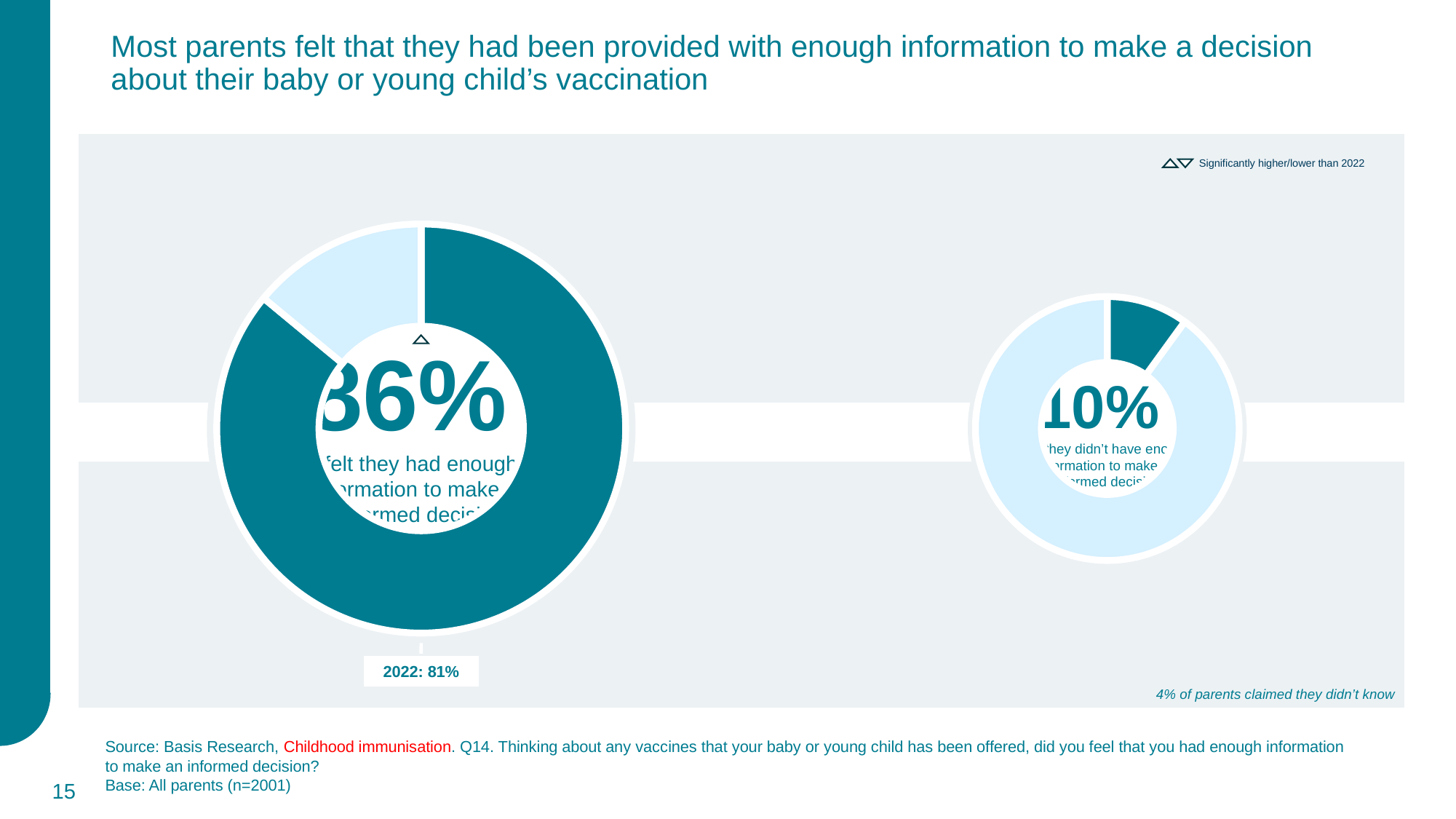
What kind of chart is used on the left of the slide to show the share of parents who felt they had enough information? doughnut chart How many pie charts are shown on the slide? 2 What is the base (sample size) stated for the charts on the slide? All parents (n=2001) On the right chart, is the share of parents who felt they didn't have enough information greater or less than 50%? less What do the triangle symbols in the top right of the chart area indicate? Significantly higher/lower than 2022 Compared with 2022, did the share of parents who felt they had enough information rise or fall, according to the triangle marker on the left chart? rose According to the note at the bottom right of the chart area, what percentage of parents claimed they didn't know? 4% On the left chart, is the share of parents who felt they had enough information greater or less than 50%? greater Which is larger: the share of parents who felt they had enough information (left chart) or the share who felt they didn't (right chart)? felt they had enough information (left chart) On the left chart, what was the 2022 value shown below the chart for parents who felt they had enough information? 2022: 81% On the right chart, what percentage of parents felt they didn't have enough information to make an informed decision? 10%